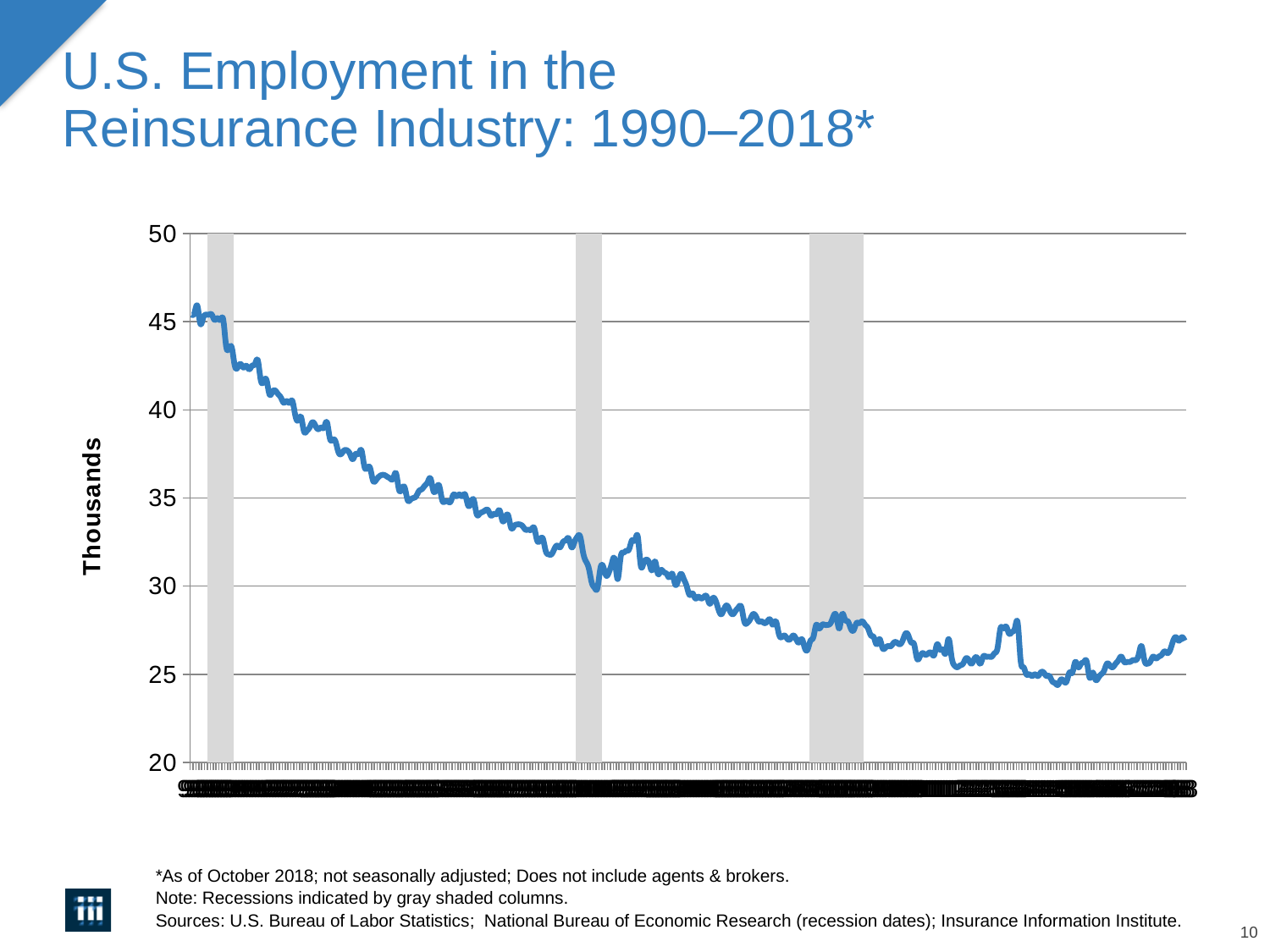
Overall, do the values rise or fall from left to right along the x axis? Fall Is the value at the start of the series (left end of the line) greater or less than 40? greater Where along the x axis does the line reach its highest value? At the start (left end) What is the highest value shown on the vertical axis? 50 Is the value at the start of the series larger or smaller than the value at the end of the series? Larger Is the value at the end of the series (right end of the line) greater or less than 30? less What is the label on the vertical axis of the chart? Thousands Is the value at the start of the series (left end of the line) greater or less than 50? less How many gray shaded recession columns are shown on the chart? 3 What kind of chart is shown on the slide? Line chart